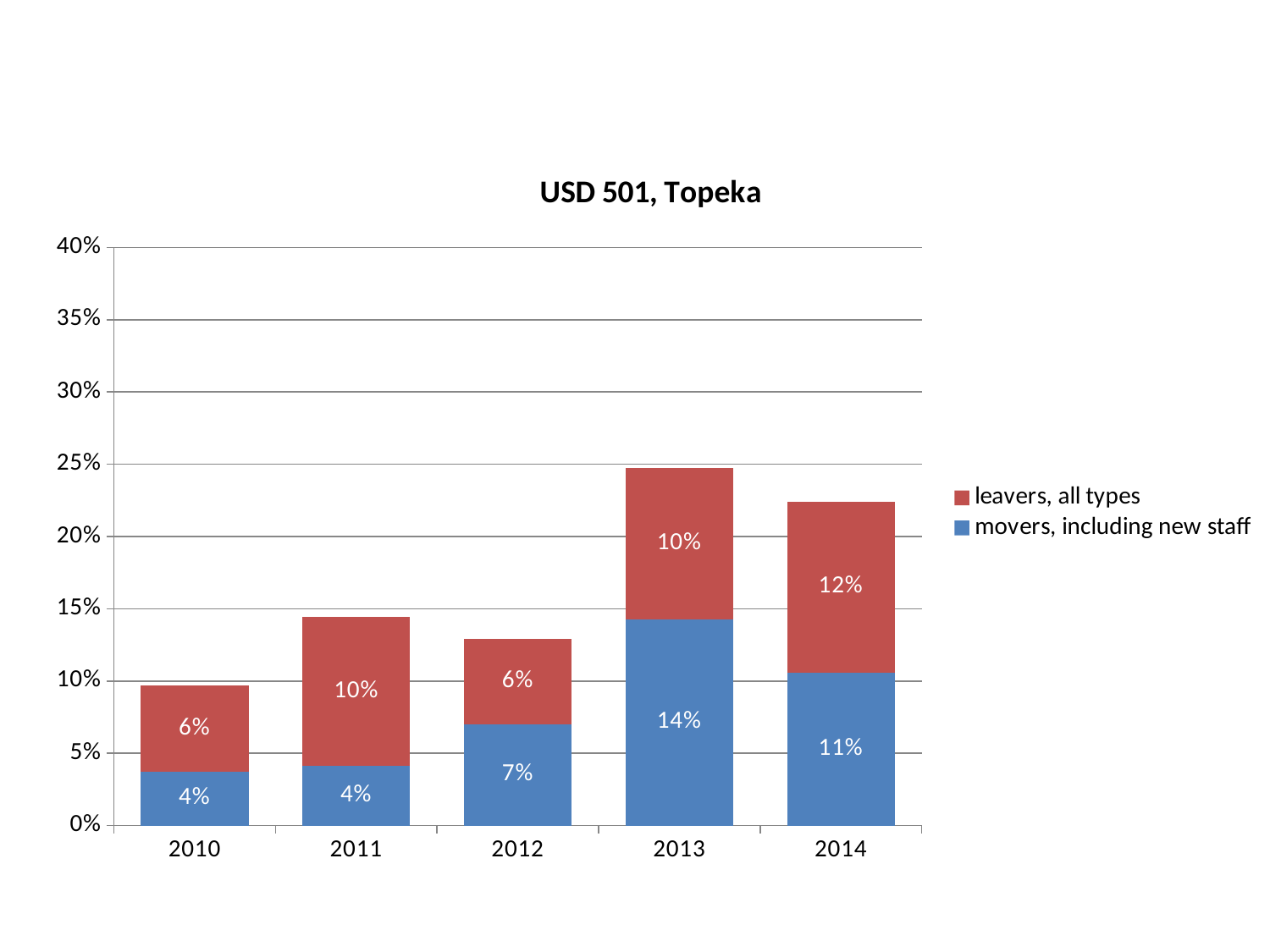
What is the title of the chart? USD 501, Topeka How many years are shown on the x axis? 5 What is the difference between the movers, including new staff values for 2013 and 2010? 10 percentage points In which year is the value for leavers, all types the highest? 2014 What type of chart is shown on the slide? Stacked bar chart Is the total height of the 2013 bar greater or less than 20%? greater What is the value for movers, including new staff in 2013? 14% What is the value for leavers, all types in 2011? 10% In 2013, which is larger: movers, including new staff or leavers, all types? movers, including new staff What is the value for leavers, all types in 2014? 12% In which year is the value for movers, including new staff the highest? 2013 How many series does the legend list? 2